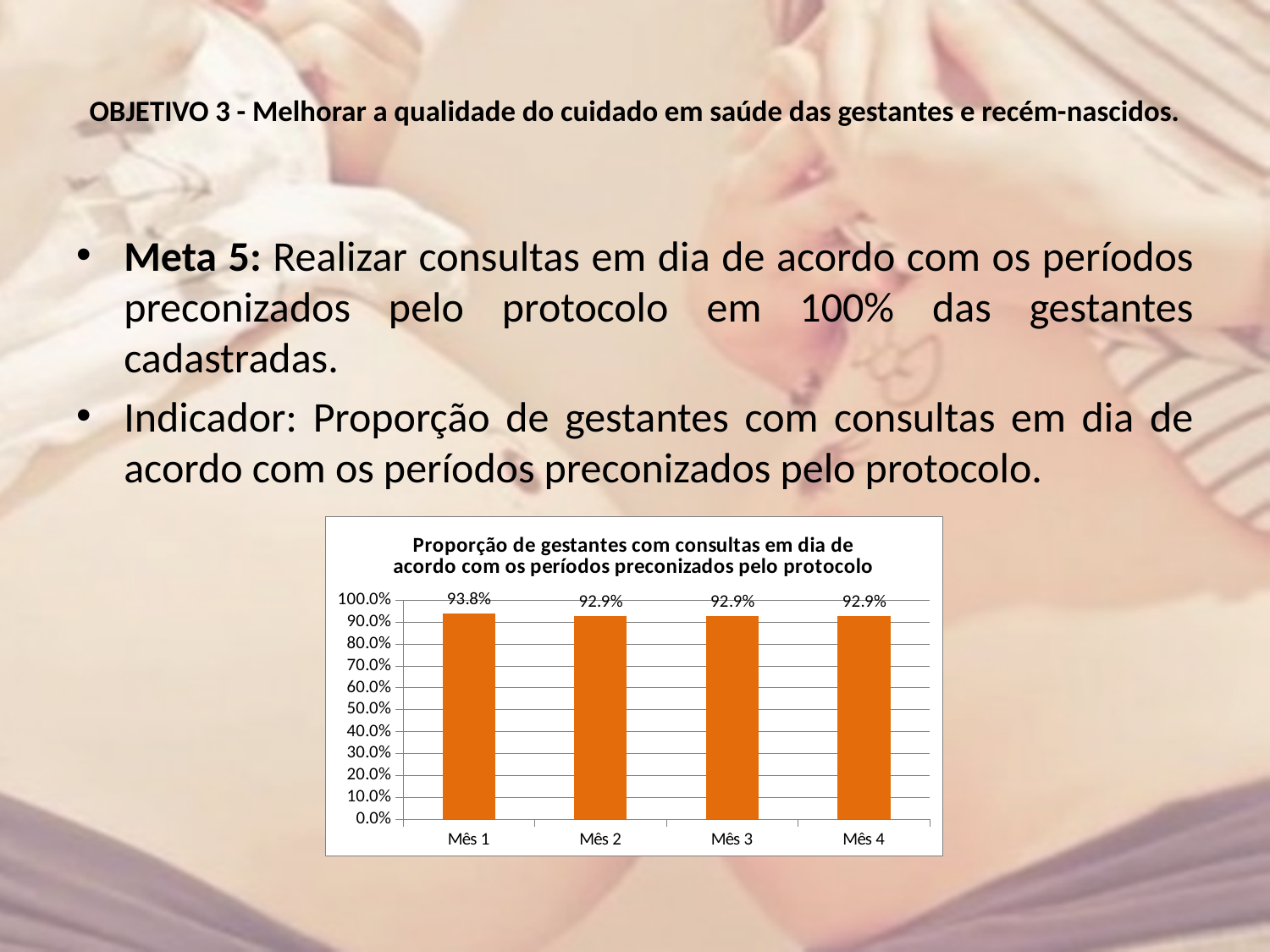
What is the value for Mês 4? 92.9% Do the values rise or fall from Mês 1 to Mês 2? fall How many months are shown on the x axis? 4 What is the title of the chart? Proporção de gestantes com consultas em dia de acordo com os períodos preconizados pelo protocolo Is the value for Mês 2 greater or less than 80.0%? greater What colour are the bars in the chart? orange What is the value for Mês 3? 92.9% What is the difference between the values for Mês 1 and Mês 2? 0.9% What kind of chart is shown on the slide? bar chart What is the value for Mês 1? 93.8% Which is larger, the value for Mês 1 or the value for Mês 4? Mês 1 Which month has the highest value? Mês 1